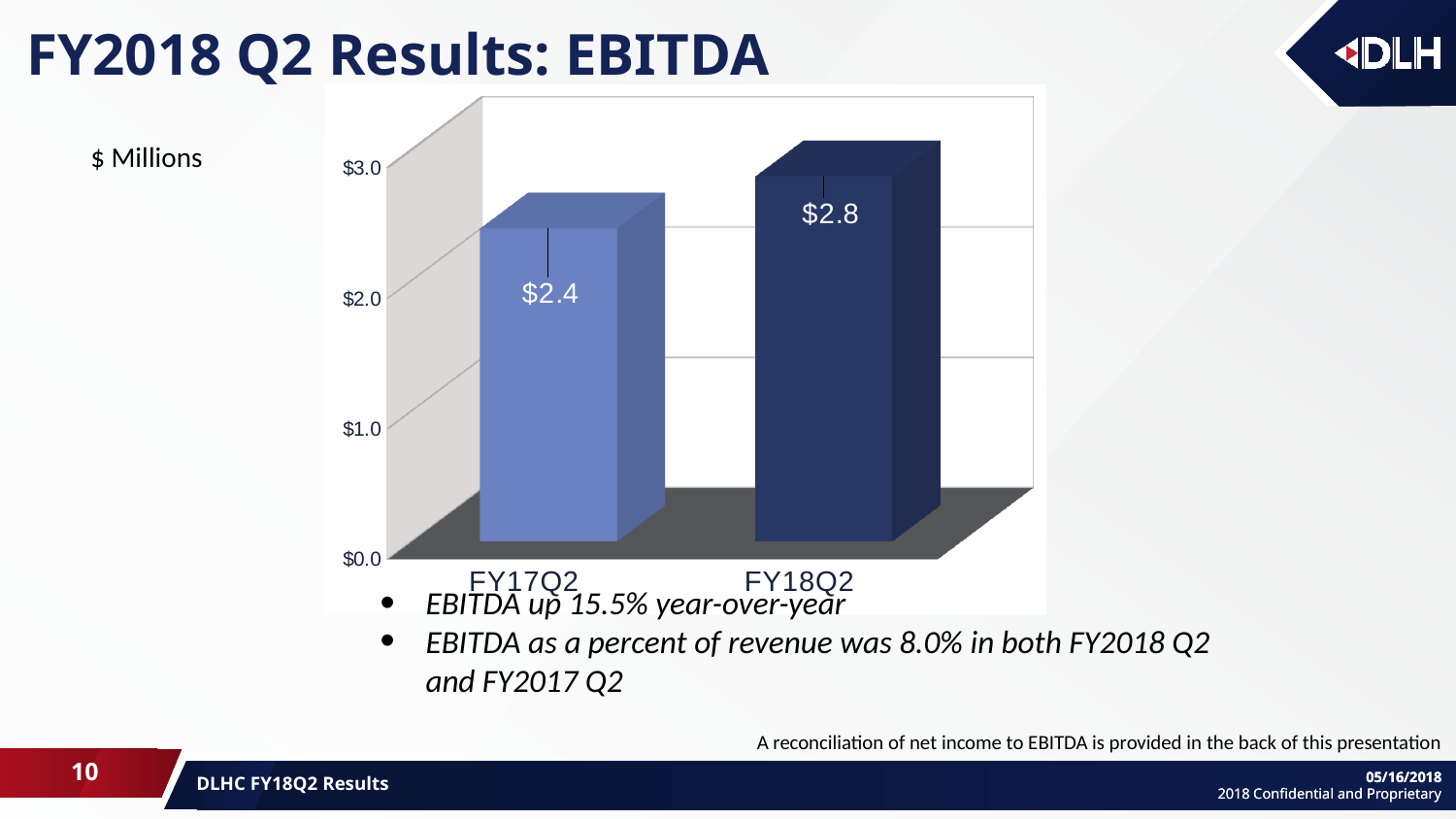
What is the EBITDA value for FY18Q2? $2.8 Does EBITDA rise or fall from FY17Q2 to FY18Q2? rise Which quarter has the higher EBITDA? FY18Q2 What is the EBITDA value for FY17Q2? $2.4 What unit is indicated for the values on the chart? $ Millions Is the EBITDA for FY18Q2 larger or smaller than for FY17Q2? larger How many quarters are shown on the chart? 2 Which quarter has the lower EBITDA? FY17Q2 Is the EBITDA value for FY17Q2 greater or less than $2.0? greater Is the EBITDA value for FY18Q2 greater or less than $3.0? less What is the difference in EBITDA between FY18Q2 and FY17Q2? $0.4 What kind of chart is shown on the slide? bar chart